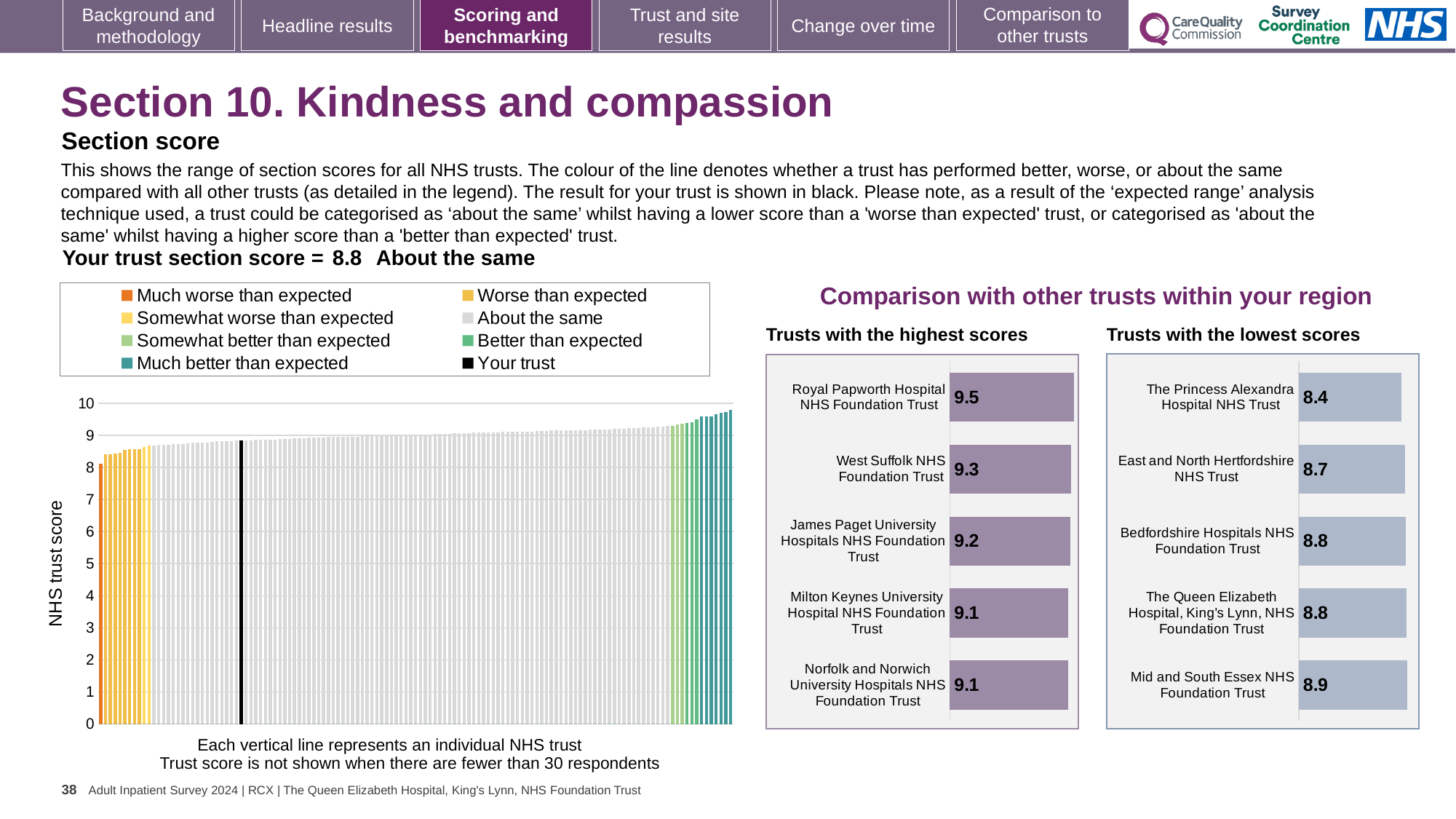
In the large chart on the left, do the trust scores rise or fall from left to right? Rise In the 'Trusts with the lowest scores' chart, what is the score for The Princess Alexandra Hospital NHS Trust? 8.4 In the 'Trusts with the lowest scores' chart, which has the larger score: East and North Hertfordshire NHS Trust or Bedfordshire Hospitals NHS Foundation Trust? Bedfordshire Hospitals NHS Foundation Trust In the 'Trusts with the lowest scores' chart, what is the score for The Queen Elizabeth Hospital, King's Lynn, NHS Foundation Trust? 8.8 How many trusts are listed in the 'Trusts with the highest scores' chart? 5 How many entries does the legend of the large chart on the left list? 8 In the 'Trusts with the highest scores' chart, what is the score for Royal Papworth Hospital NHS Foundation Trust? 9.5 In the 'Trusts with the lowest scores' chart, which trust has the highest score? Mid and South Essex NHS Foundation Trust What kind of chart is the large chart on the left showing NHS trust scores? Bar chart In the 'Trusts with the highest scores' chart, what is the difference between the scores of Royal Papworth Hospital NHS Foundation Trust and West Suffolk NHS Foundation Trust? 0.2 In the 'Trusts with the highest scores' chart, which trust has the lowest score shown? Milton Keynes University Hospital NHS Foundation Trust and Norfolk and Norwich University Hospitals NHS Foundation Trust (both 9.1) What is the y-axis label of the large chart on the left? NHS trust score